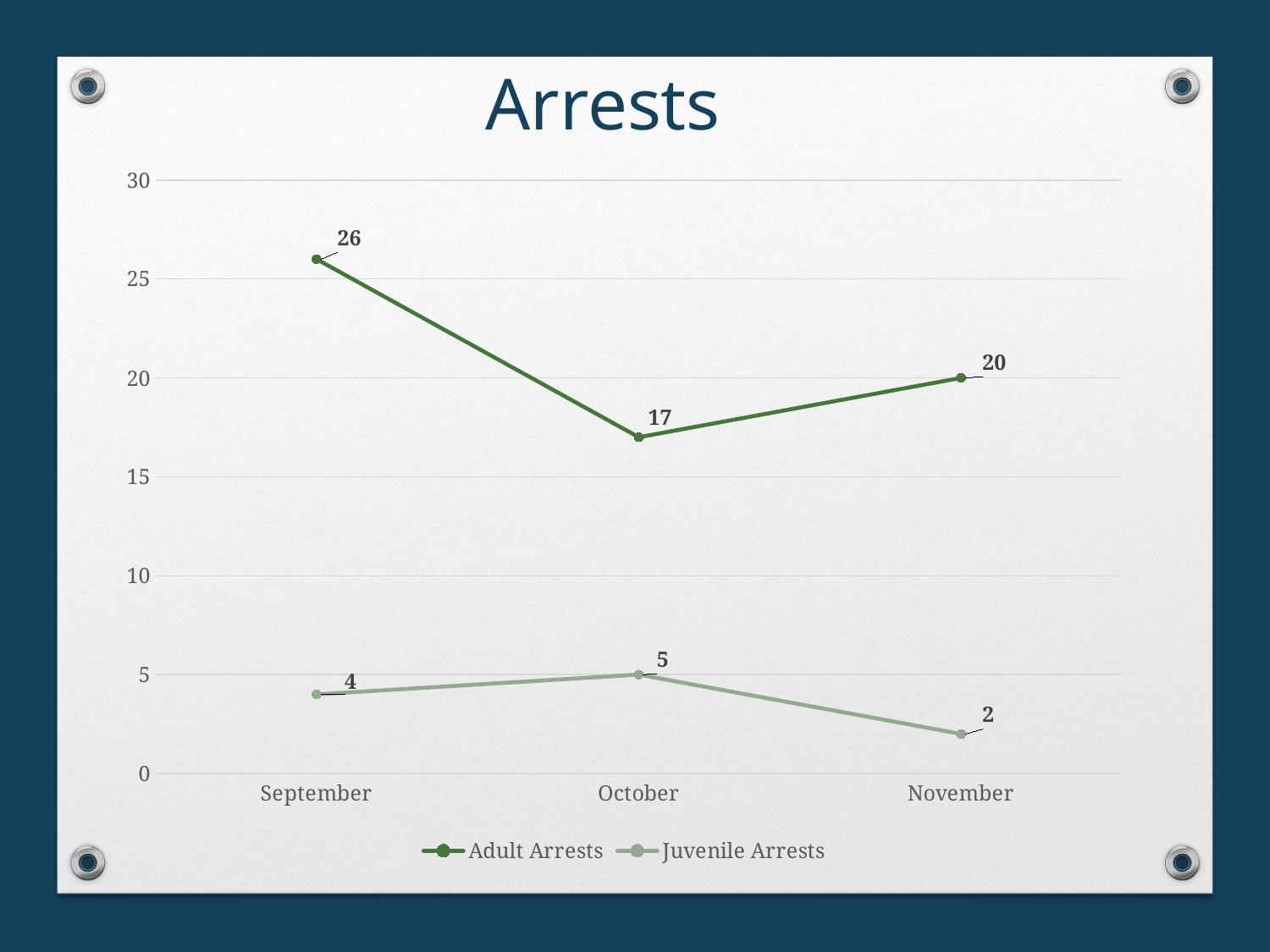
What is the title of the chart? Arrests What is the difference between Adult Arrests in September and October? 9 In which month are Juvenile Arrests lowest? November How many months are shown on the x axis? 3 What is the value for Juvenile Arrests in November? 2 In which month are Adult Arrests highest? September Which is larger, Juvenile Arrests in October or Juvenile Arrests in September? October What kind of chart is shown on the slide? Line chart What is the difference between Adult Arrests and Juvenile Arrests in November? 18 How many series does the legend list? 2 What is the value for Adult Arrests in October? 17 What is the value for Adult Arrests in September? 26